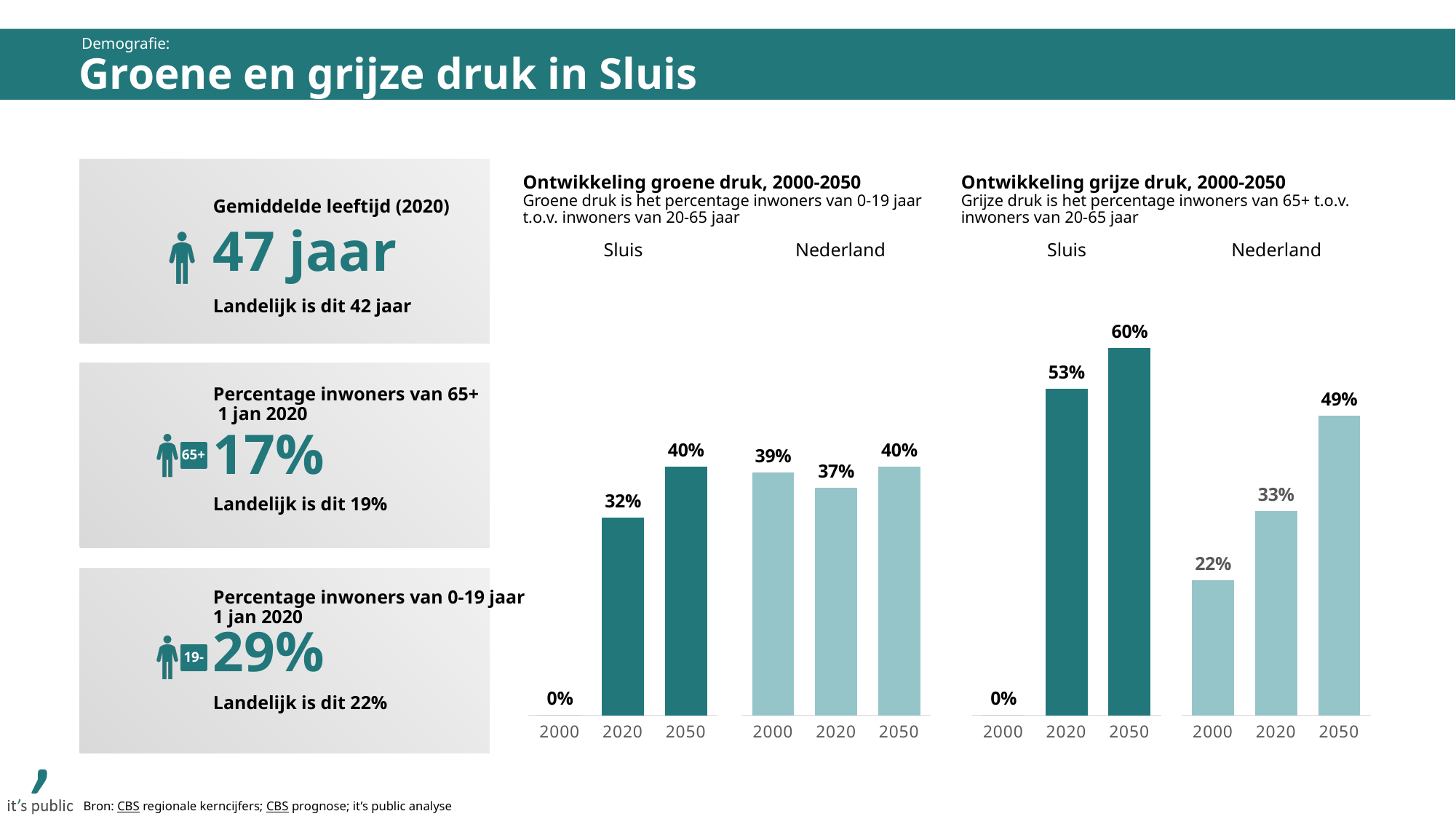
In the chart 'Ontwikkeling grijze druk, 2000-2050', what is the value for Nederland in 2020? 33% How many bars are shown for Nederland in the chart 'Ontwikkeling groene druk, 2000-2050'? 3 What kind of chart is 'Ontwikkeling grijze druk, 2000-2050'? bar chart In the chart 'Ontwikkeling grijze druk, 2000-2050', which bar is the highest? Sluis 2050 In the chart 'Ontwikkeling groene druk, 2000-2050', what is the value for Nederland in 2000? 39% In the chart 'Ontwikkeling grijze druk, 2000-2050', what is the difference between Sluis and Nederland in 2020? 20% In the chart 'Ontwikkeling groene druk, 2000-2050', what is the value for Sluis in 2020? 32% In the chart 'Ontwikkeling grijze druk, 2000-2050', do the values for Nederland rise or fall from 2000 to 2050? rise In the chart 'Ontwikkeling grijze druk, 2000-2050', which is larger: Sluis in 2020 or Nederland in 2050? Sluis in 2020 In the chart 'Ontwikkeling groene druk, 2000-2050', what is the difference between Nederland in 2000 and Nederland in 2020? 2% In the chart 'Ontwikkeling groene druk, 2000-2050', which is larger: Sluis in 2020 or Nederland in 2020? Nederland in 2020 In the chart 'Ontwikkeling grijze druk, 2000-2050', what is the value for Sluis in 2050? 60%